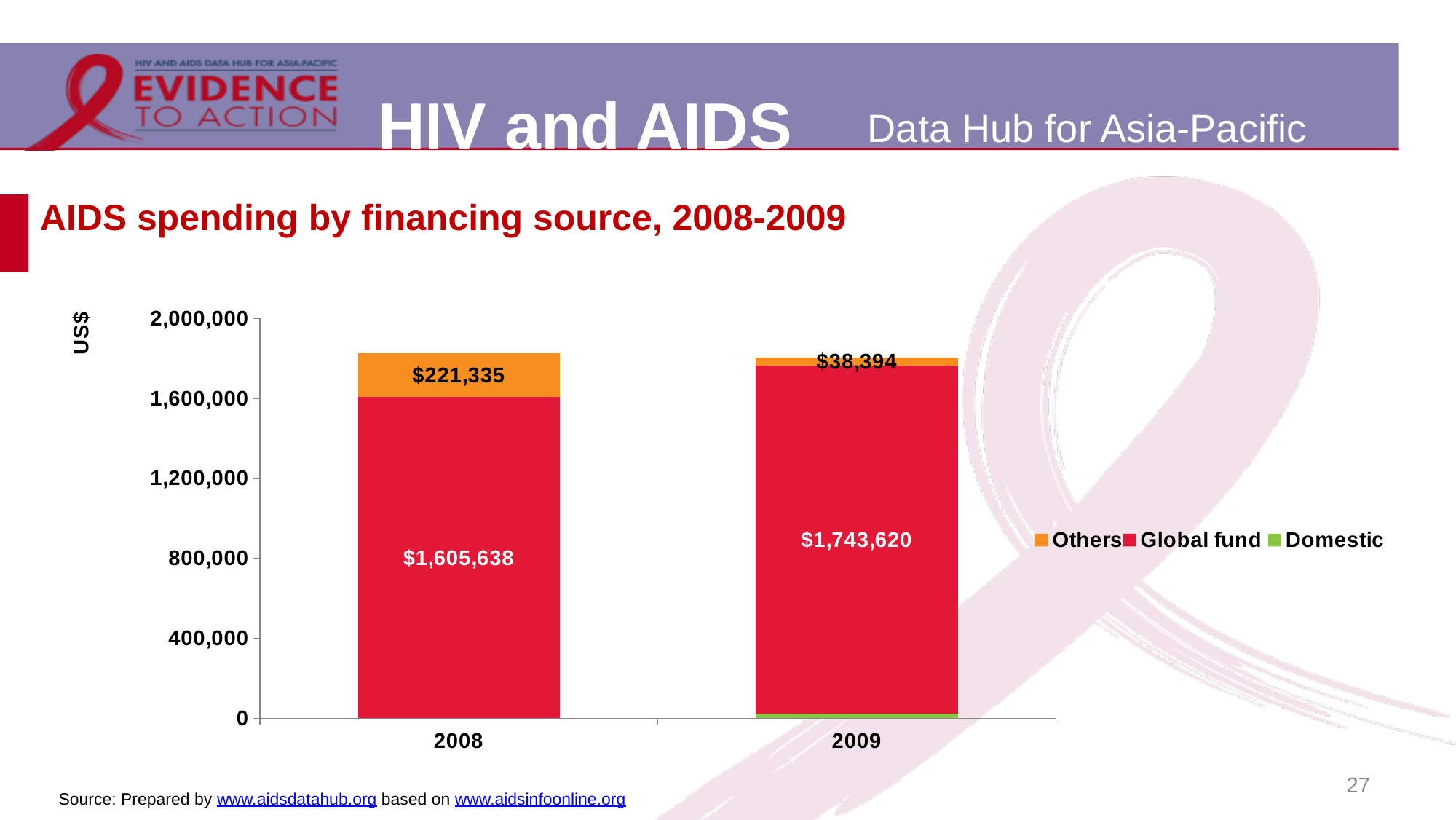
By how much did Global fund spending increase from 2008 to 2009? $137,982 What was the Global fund spending in 2008? $1,605,638 What was the spending from Others in 2008? $221,335 In which year was Global fund spending higher? 2009 What was the Global fund spending in 2009? $1,743,620 What was the spending from Others in 2009? $38,394 Is the total height of the 2008 bar greater or less than 1,600,000? greater What kind of chart is shown on the slide? Stacked bar chart By how much did spending from Others decrease from 2008 to 2009? $182,941 How many years are shown on the x axis? 2 In which year was spending from Others lower? 2009 How many financing sources does the legend list? 3